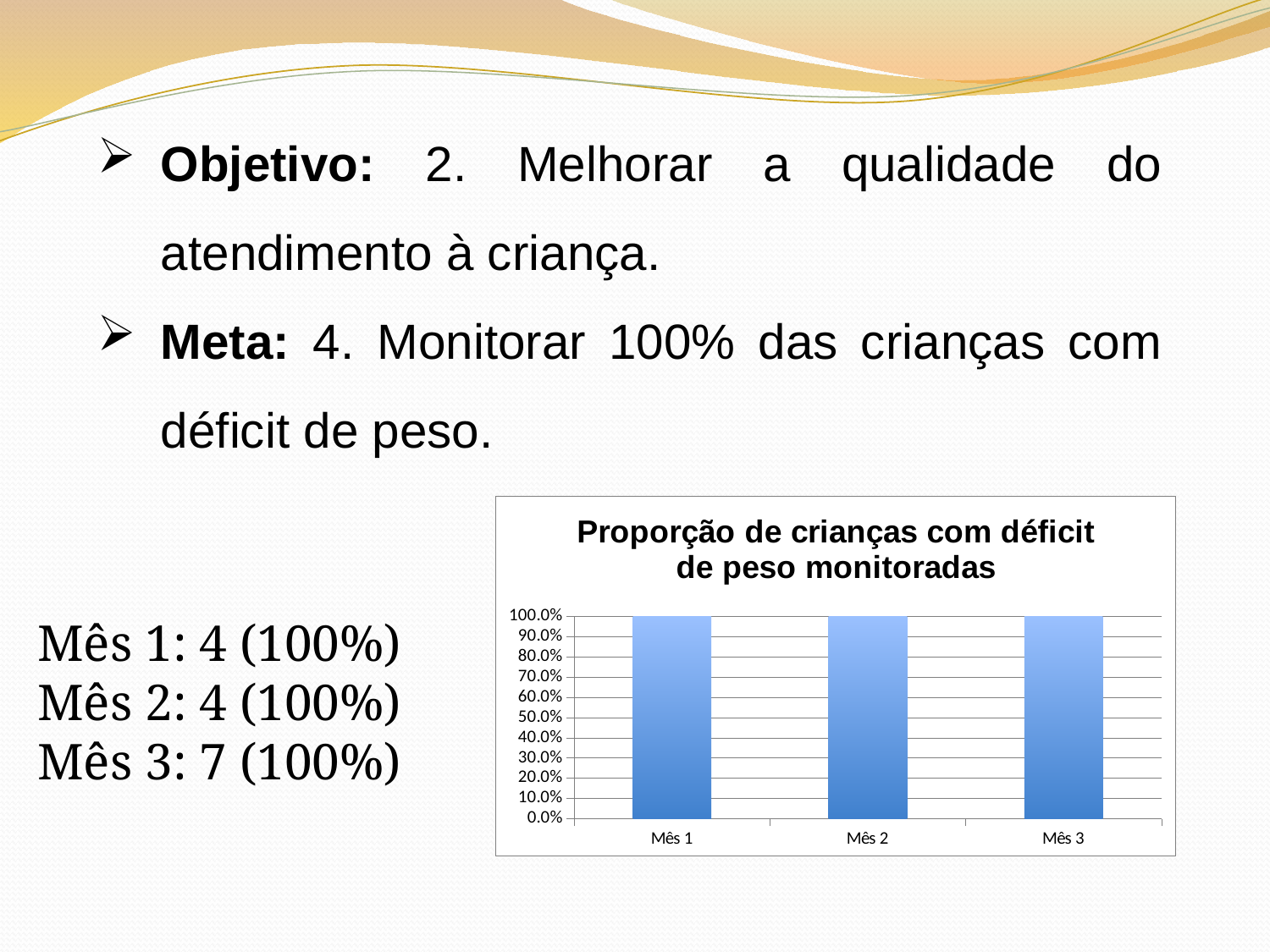
What is the label of the first category on the x axis? Mês 1 How many categories are plotted on the x axis of the chart? 3 What value does the bar for Mês 1 reach on the y axis? 100.0% What is the highest tick value shown on the y axis? 100.0% What value does the bar for Mês 2 reach on the y axis? 100.0% Is the value for Mês 3 greater or less than 90.0%? greater Do the values rise, fall, or stay the same from Mês 1 to Mês 3? stay the same What value does the bar for Mês 3 reach on the y axis? 100.0% What is the title of the chart? Proporção de crianças com déficit de peso monitoradas What kind of chart is shown on the slide? bar chart Is the value for Mês 2 greater or less than 50.0%? greater What is the difference between the values for Mês 1 and Mês 3? 0.0%